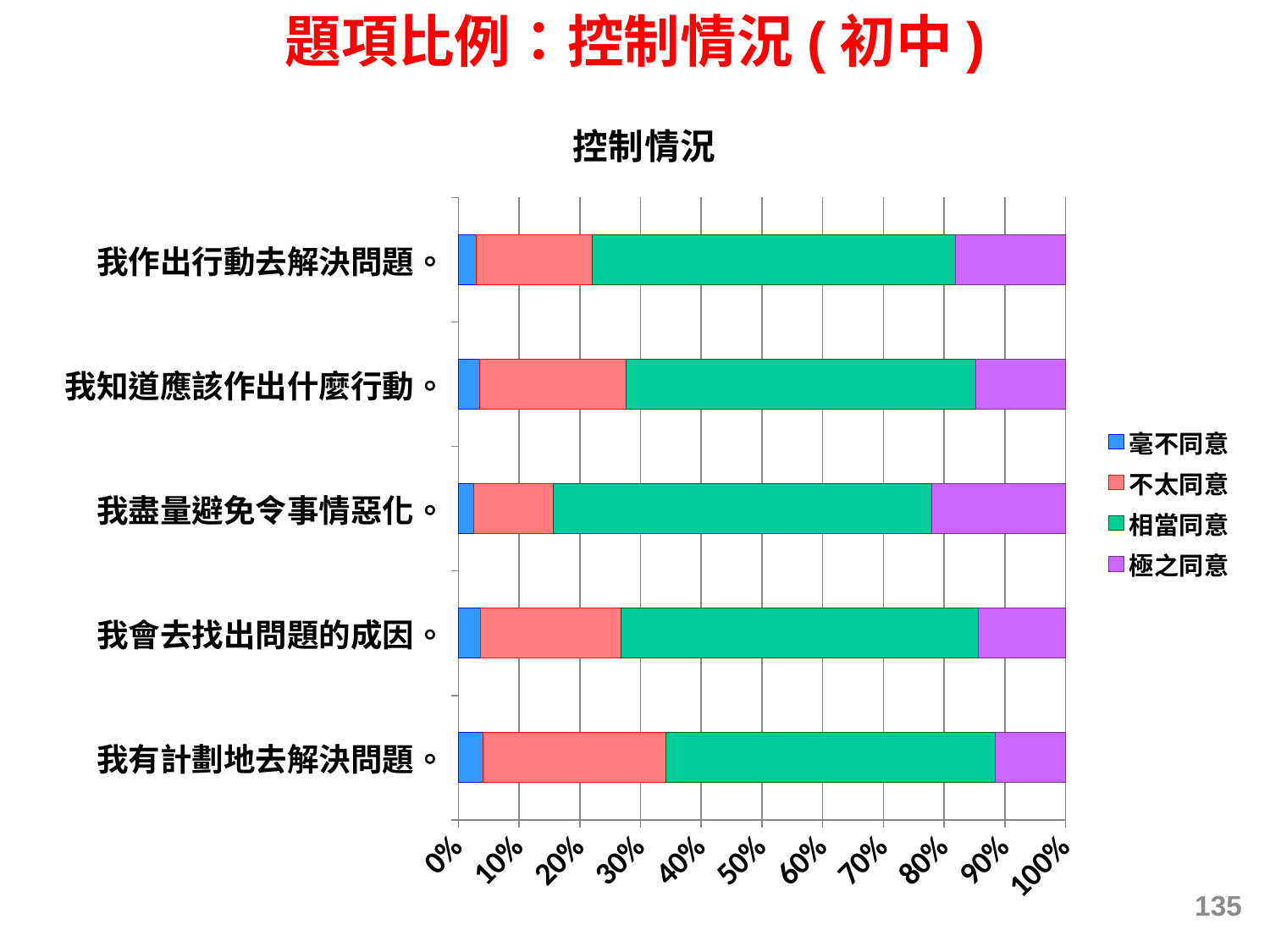
What kind of chart is shown on the slide? stacked bar chart What is the title of the chart on the slide? 控制情況 How many question items (categories) are plotted in the 控制情況 chart? 5 Which item has the smallest 不太同意 segment? 我盡量避免令事情惡化 Which legend entry is shown in green? 相當同意 How many series does the legend of the 控制情況 chart list? 4 Which is larger: the 相當同意 segment for 我盡量避免令事情惡化 or the 相當同意 segment for 我有計劃地去解決問題? 我盡量避免令事情惡化 Which item has the largest 極之同意 segment? 我盡量避免令事情惡化 Which item has the largest 不太同意 segment? 我有計劃地去解決問題 Is the combined share of 毫不同意 and 不太同意 for 我盡量避免令事情惡化 greater or less than 20%? less Is the combined share of 毫不同意 and 不太同意 for 我有計劃地去解決問題 greater or less than 30%? greater What is the total of the stacked bar for 我作出行動去解決問題? 100%